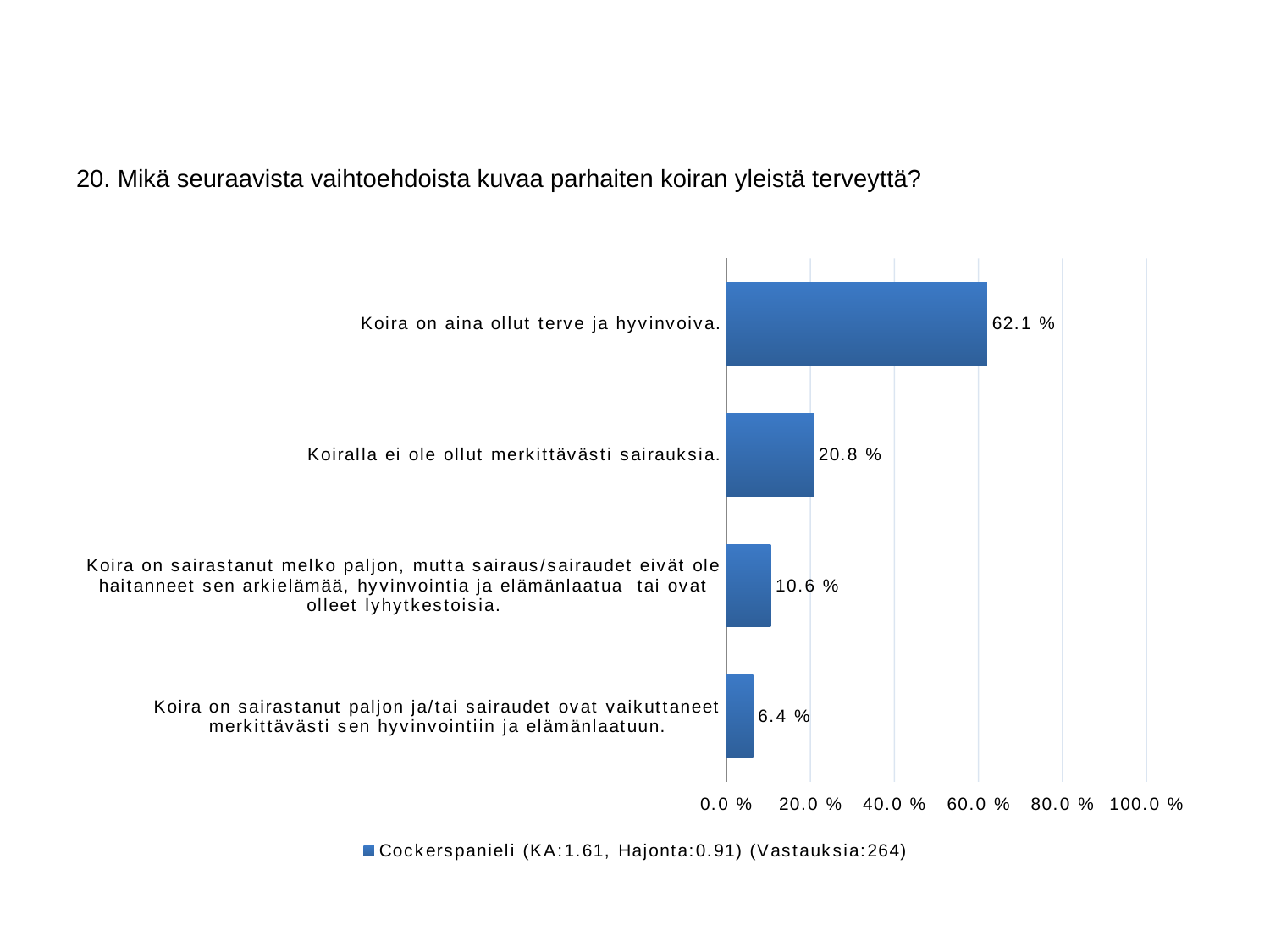
What is the value for "Koira on sairastanut paljon ja/tai sairaudet ovat vaikuttaneet merkittävästi sen hyvinvointiin ja elämänlaatuun."? 6.4 % How many responses (Vastauksia) does the legend report? 264 How many series does the legend list? 1 Which category has the highest value? Koira on aina ollut terve ja hyvinvoiva. How many categories are shown in the chart? 4 What is the difference between the values for "Koira on aina ollut terve ja hyvinvoiva." and "Koiralla ei ole ollut merkittävästi sairauksia."? 41.3 % What is the value for "Koiralla ei ole ollut merkittävästi sairauksia."? 20.8 % What is the value for "Koira on aina ollut terve ja hyvinvoiva."? 62.1 % Which is larger: the value for "Koiralla ei ole ollut merkittävästi sairauksia." or the value for the category with 10.6 %? Koiralla ei ole ollut merkittävästi sairauksia. Which category has the lowest value? Koira on sairastanut paljon ja/tai sairaudet ovat vaikuttaneet merkittävästi sen hyvinvointiin ja elämänlaatuun. Is the value for "Koira on aina ollut terve ja hyvinvoiva." greater or less than 60.0 %? greater What kind of chart is shown on the slide? bar chart